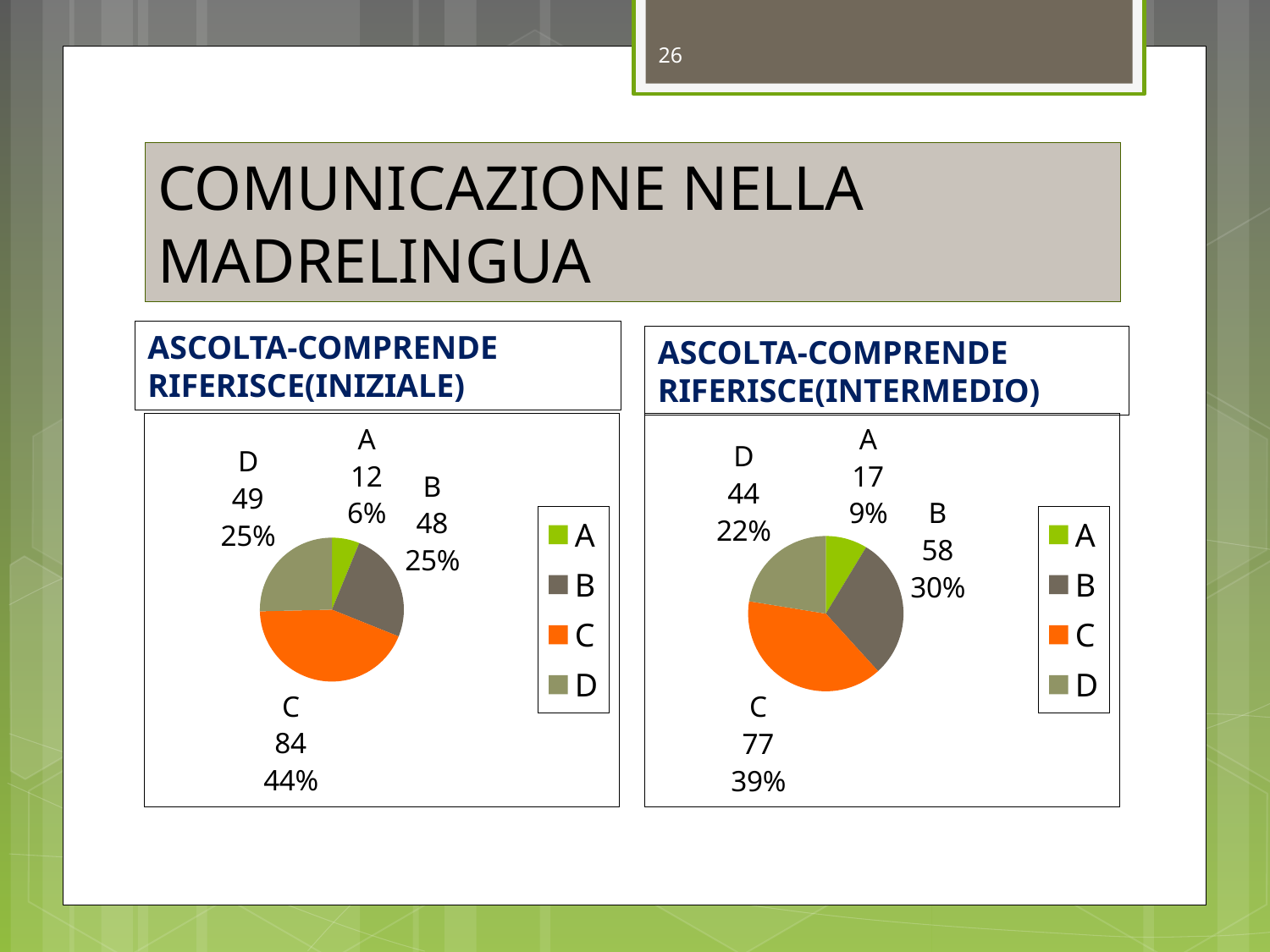
In the ASCOLTA-COMPRENDE RIFERISCE(INTERMEDIO) chart, what percentage share does D have? 22% In the ASCOLTA-COMPRENDE RIFERISCE(INIZIALE) chart, what is the value for C? 84 How many categories does the ASCOLTA-COMPRENDE RIFERISCE(INIZIALE) chart show? 4 In the ASCOLTA-COMPRENDE RIFERISCE(INTERMEDIO) chart, what is the value for B? 58 In the ASCOLTA-COMPRENDE RIFERISCE(INIZIALE) chart, which category has the largest slice? C In the ASCOLTA-COMPRENDE RIFERISCE(INTERMEDIO) chart, what colour is the slice for C? Orange In the ASCOLTA-COMPRENDE RIFERISCE(INTERMEDIO) chart, what is the difference between the values for C and B? 19 In the ASCOLTA-COMPRENDE RIFERISCE(INIZIALE) chart, what percentage share does A have? 6% How many entries does the legend of the ASCOLTA-COMPRENDE RIFERISCE(INIZIALE) chart list? 4 In the ASCOLTA-COMPRENDE RIFERISCE(INTERMEDIO) chart, which category has the smallest slice? A What kind of chart is the ASCOLTA-COMPRENDE RIFERISCE(INTERMEDIO) chart? Pie chart In the ASCOLTA-COMPRENDE RIFERISCE(INIZIALE) chart, which is larger, the value for D or the value for A? D